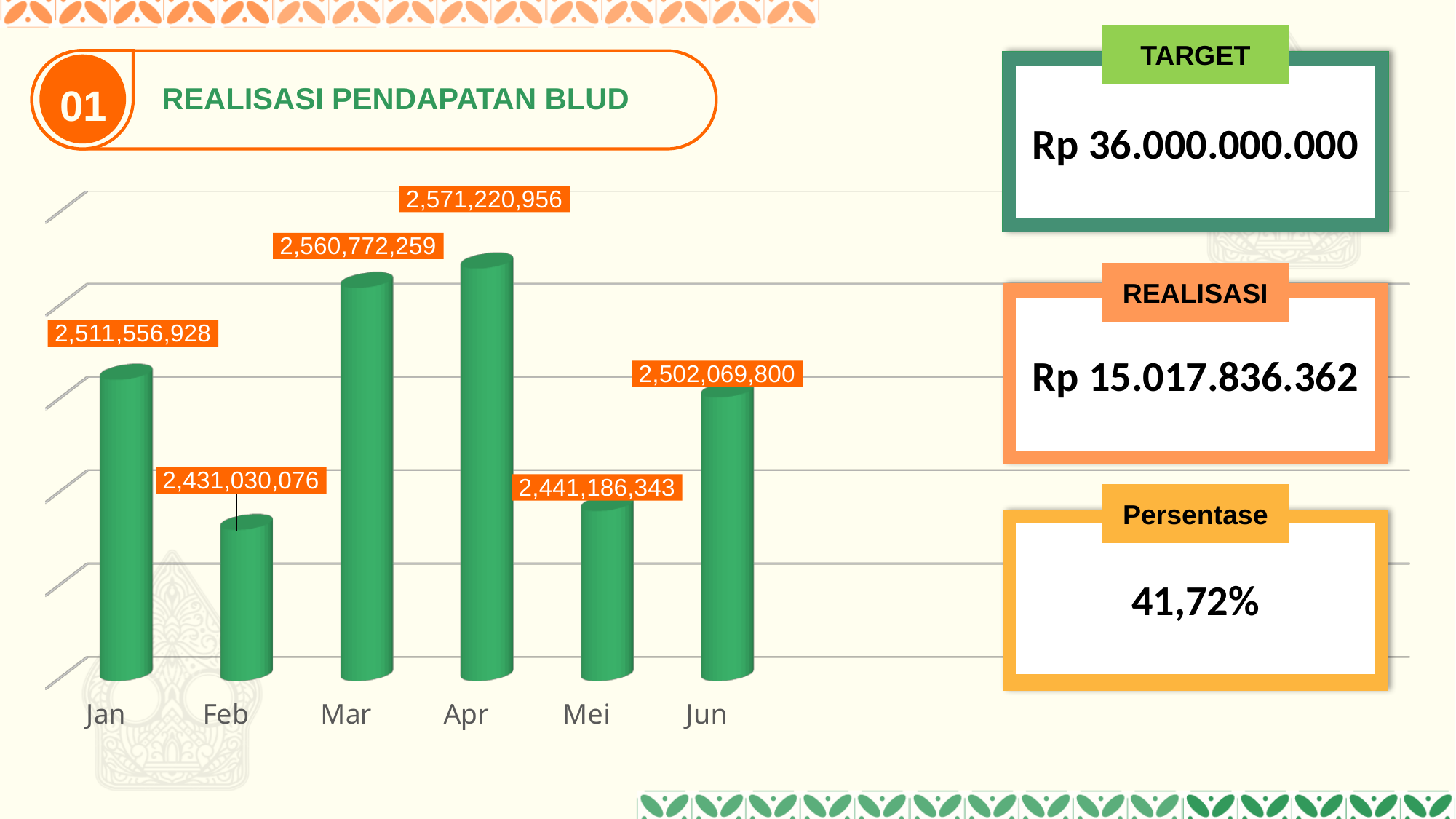
Which is larger, the value for Jan or the value for Jun? Jan Does the value rise or fall from Jan to Feb? Fall What is the title shown above the chart? REALISASI PENDAPATAN BLUD What is the value for Mei? 2,441,186,343 What is the difference between the values for Apr and Mar? 10,448,697 Which month has the highest value? Apr What is the value for Jun? 2,502,069,800 What is the difference between the values for Jan and Feb? 80,526,852 What is the value for Jan? 2,511,556,928 How many months are shown on the x axis? 6 Which month has the lowest value? Feb What kind of chart is shown on the slide? Bar chart